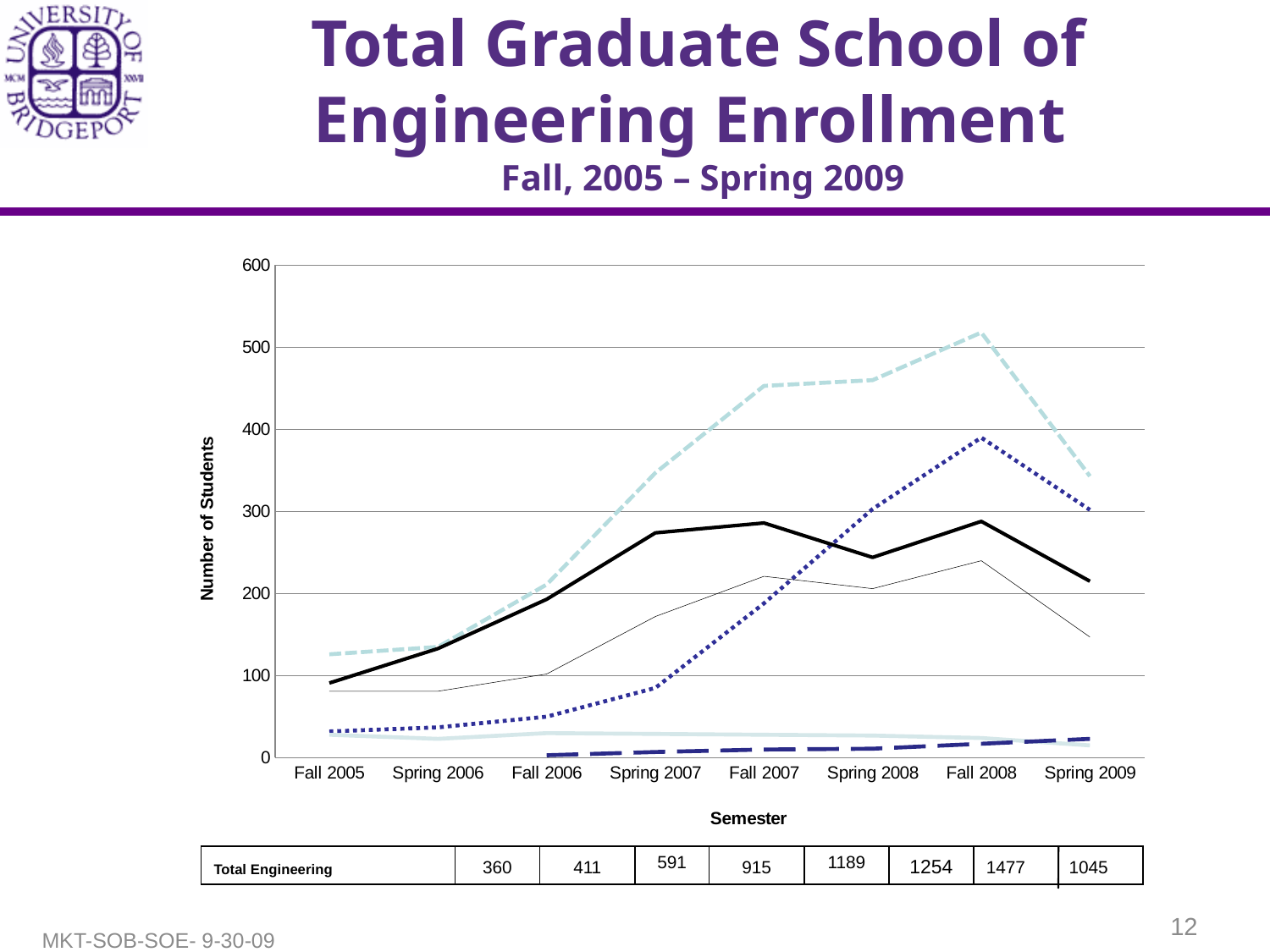
What is the difference between the Total Engineering enrollment for Spring 2006 and Fall 2005? 51 What kind of chart is shown on the slide? line chart What is the Total Engineering enrollment for Spring 2009 in the table below the chart? 1045 What is the Total Engineering enrollment for Fall 2005 in the table below the chart? 360 How many semesters are shown along the x axis of the chart? 8 What is the Total Engineering enrollment for Fall 2007 in the table below the chart? 1189 What is the difference between the Total Engineering enrollment for Fall 2008 and Spring 2009? 432 Which is larger, the Total Engineering enrollment for Spring 2007 or for Fall 2007? Fall 2007 Does the Total Engineering enrollment rise or fall from Fall 2005 to Fall 2008? rise Which semester has the highest Total Engineering enrollment in the table? Fall 2008 What is the title of the vertical axis of the chart? Number of Students Which semester has the lowest Total Engineering enrollment in the table? Fall 2005